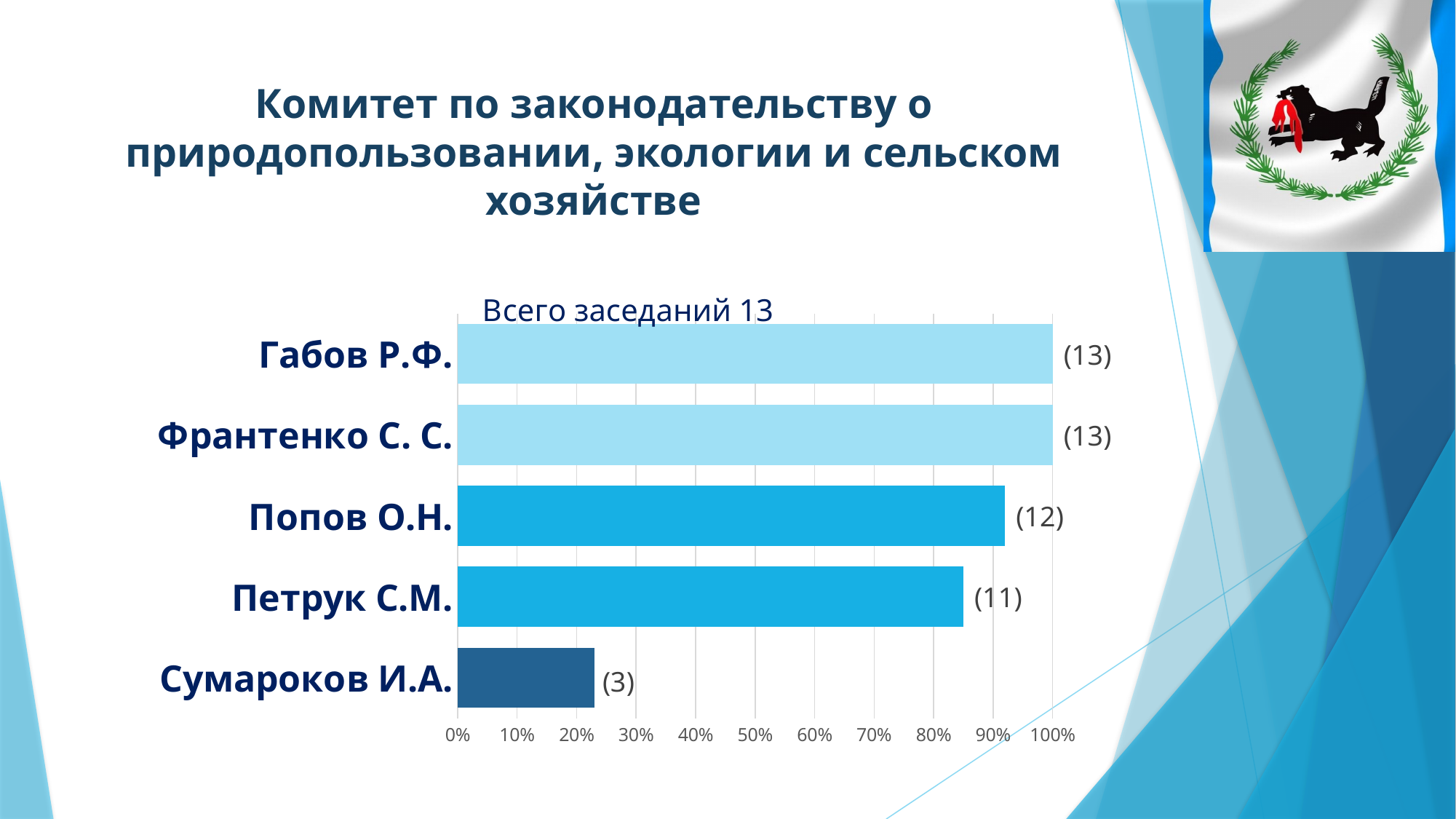
Which category has the lowest value? Сумароков И.А. What is the data label shown for Петрук С.М.? (11) What is the difference between the labelled values for Франтенко С. С. and Петрук С.М.? 2 What is the data label shown for Габов Р.Ф.? (13) Is the bar for Петрук С.М. greater or less than 80%? greater What kind of chart is shown on the slide? bar chart Is the bar for Сумароков И.А. greater or less than 30%? less What is the data label shown for Попов О.Н.? (12) What is the data label shown for Сумароков И.А.? (3) How many categories are shown in the chart? 5 Which is larger, the value for Попов О.Н. or the value for Петрук С.М.? Попов О.Н. What is the difference between the labelled values for Попов О.Н. and Сумароков И.А.? 9